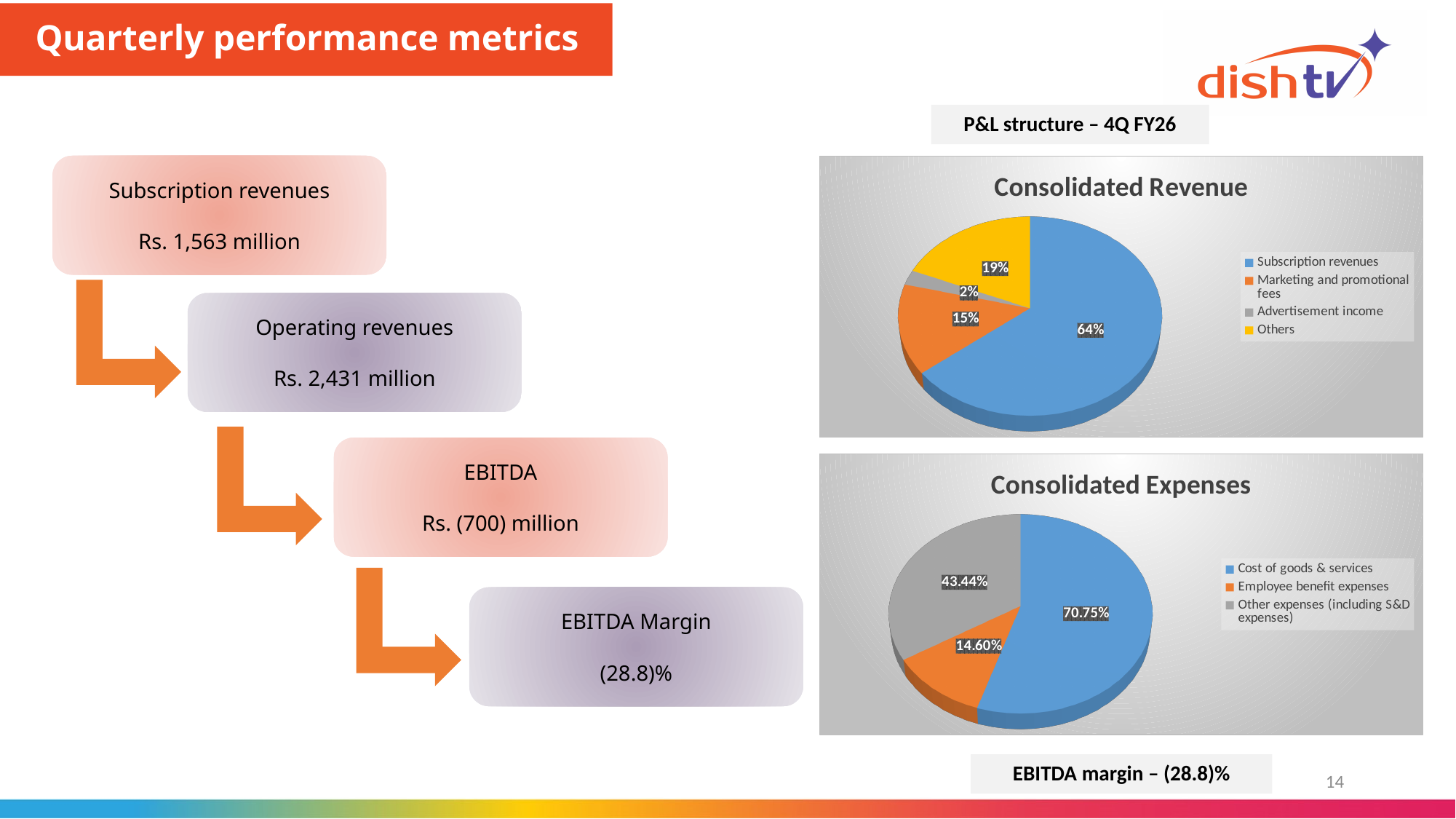
In the Consolidated Expenses chart, what colour represents Other expenses (including S&D expenses)? Grey In the Consolidated Revenue chart, what share does Subscription revenues have? 64% What type of chart is the Consolidated Expenses chart? Pie chart In the Consolidated Revenue chart, what share does Advertisement income have? 2% In the Consolidated Revenue chart, how many categories does the legend list? 4 In the Consolidated Expenses chart, which category has the smallest share? Employee benefit expenses In the Consolidated Revenue chart, what is the difference between the Others share and the Marketing and promotional fees share? 4% In the Consolidated Revenue chart, which category has the smallest share? Advertisement income In the Consolidated Revenue chart, what share does Marketing and promotional fees have? 15% In the Consolidated Revenue chart, which category has the largest share? Subscription revenues In the Consolidated Expenses chart, what share does Employee benefit expenses have? 14.60% In the Consolidated Expenses chart, what share does Cost of goods & services have? 70.75%